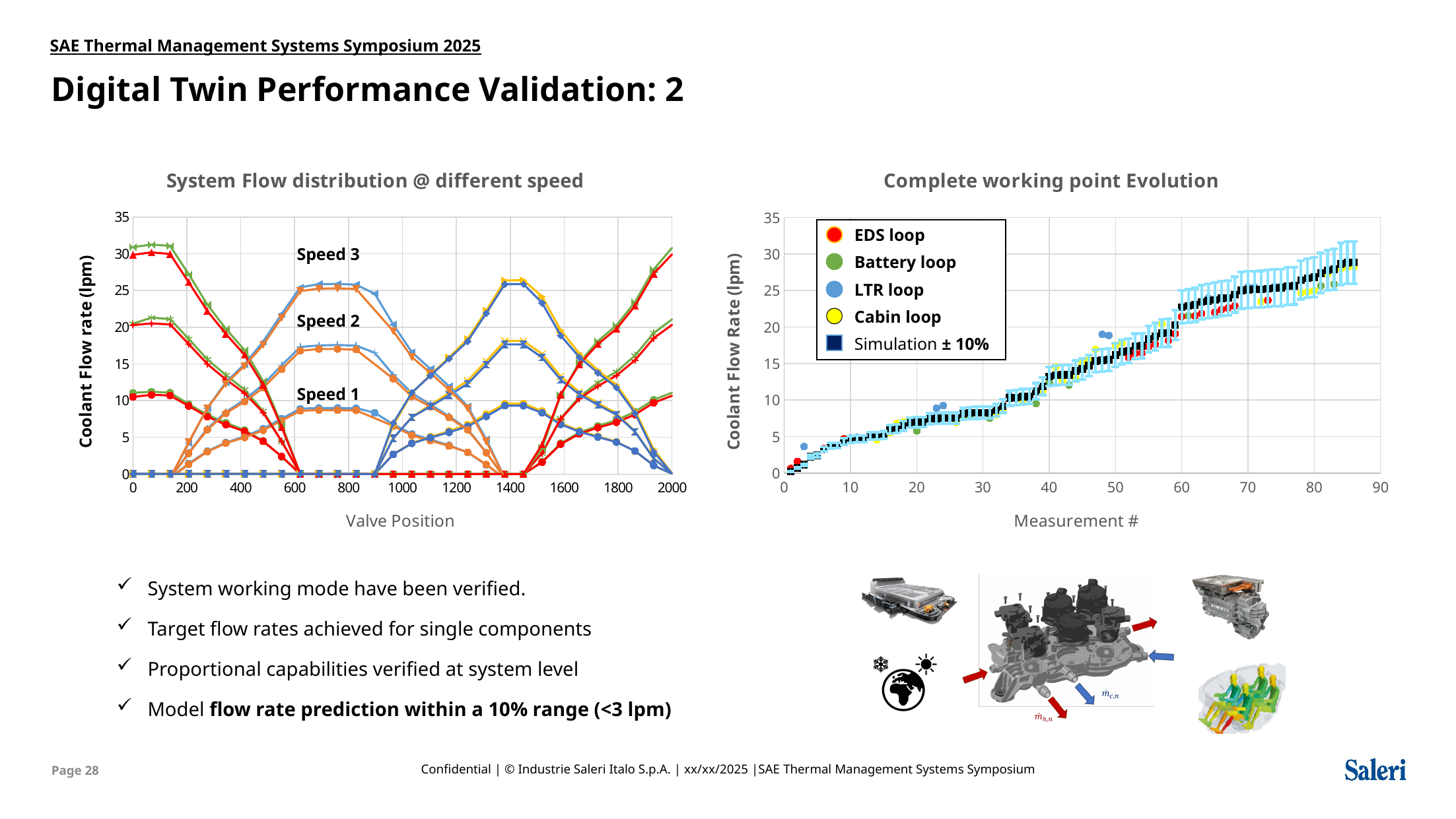
What kind of chart is the 'Complete working point Evolution' chart on the right? scatter chart What kind of chart is the 'System Flow distribution @ different speed' chart on the left? line chart In the 'System Flow distribution @ different speed' chart, is the Speed 3 flow rate at valve position 0 greater or less than 25? greater In the 'Complete working point Evolution' chart, is the coolant flow rate at measurement 10 greater or less than 10? less In the 'System Flow distribution @ different speed' chart, is the Speed 1 flow rate at valve position 0 greater or less than 15? less What is the x-axis label of the 'System Flow distribution @ different speed' chart? Valve Position In the 'Complete working point Evolution' chart, do the values rise or fall as the measurement number increases? rise In the 'Complete working point Evolution' chart, how many series does the legend list? 5 In the 'System Flow distribution @ different speed' chart, which speed curve is higher at valve position 0, Speed 3 or Speed 1? Speed 3 In the 'Complete working point Evolution' chart, what tolerance is shown for the Simulation series in the legend? ± 10%